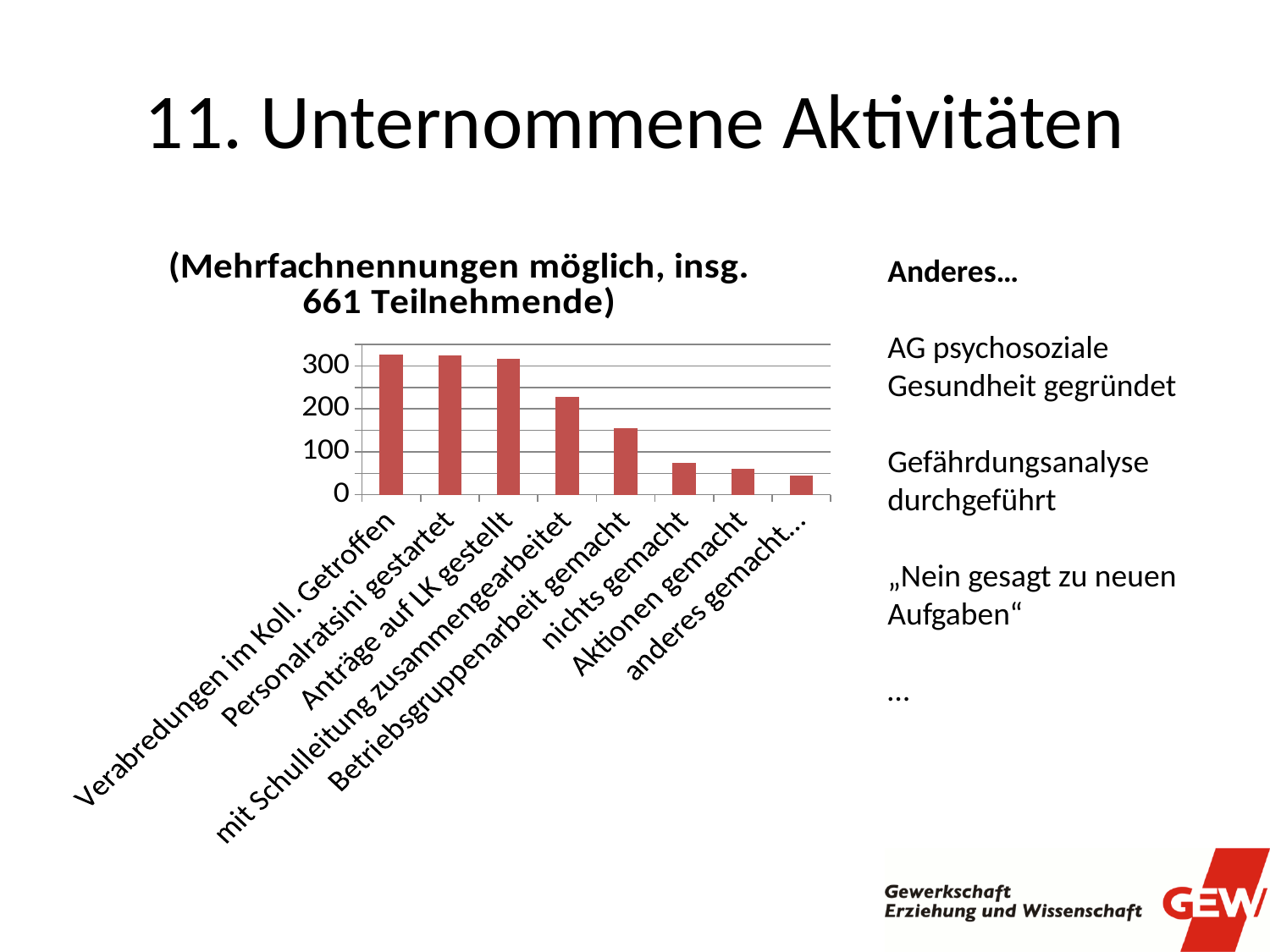
Is the value for "mit Schulleitung zusammengearbeitet" greater or less than 200? greater Is the value for "Aktionen gemacht" greater or less than 100? less Is the value for "nichts gemacht" greater or less than 100? less Do the bar values rise or fall from left to right along the x axis? fall Which is larger, the value for "Betriebsgruppenarbeit gemacht" or the value for "nichts gemacht"? Betriebsgruppenarbeit gemacht What is the title of the chart? (Mehrfachnennungen möglich, insg. 661 Teilnehmende) Which category has the lowest value in the chart? anderes gemacht... How many categories are plotted in the chart? 8 Which is larger, the value for "Anträge auf LK gestellt" or the value for "mit Schulleitung zusammengearbeitet"? Anträge auf LK gestellt What kind of chart is shown on the slide? bar chart